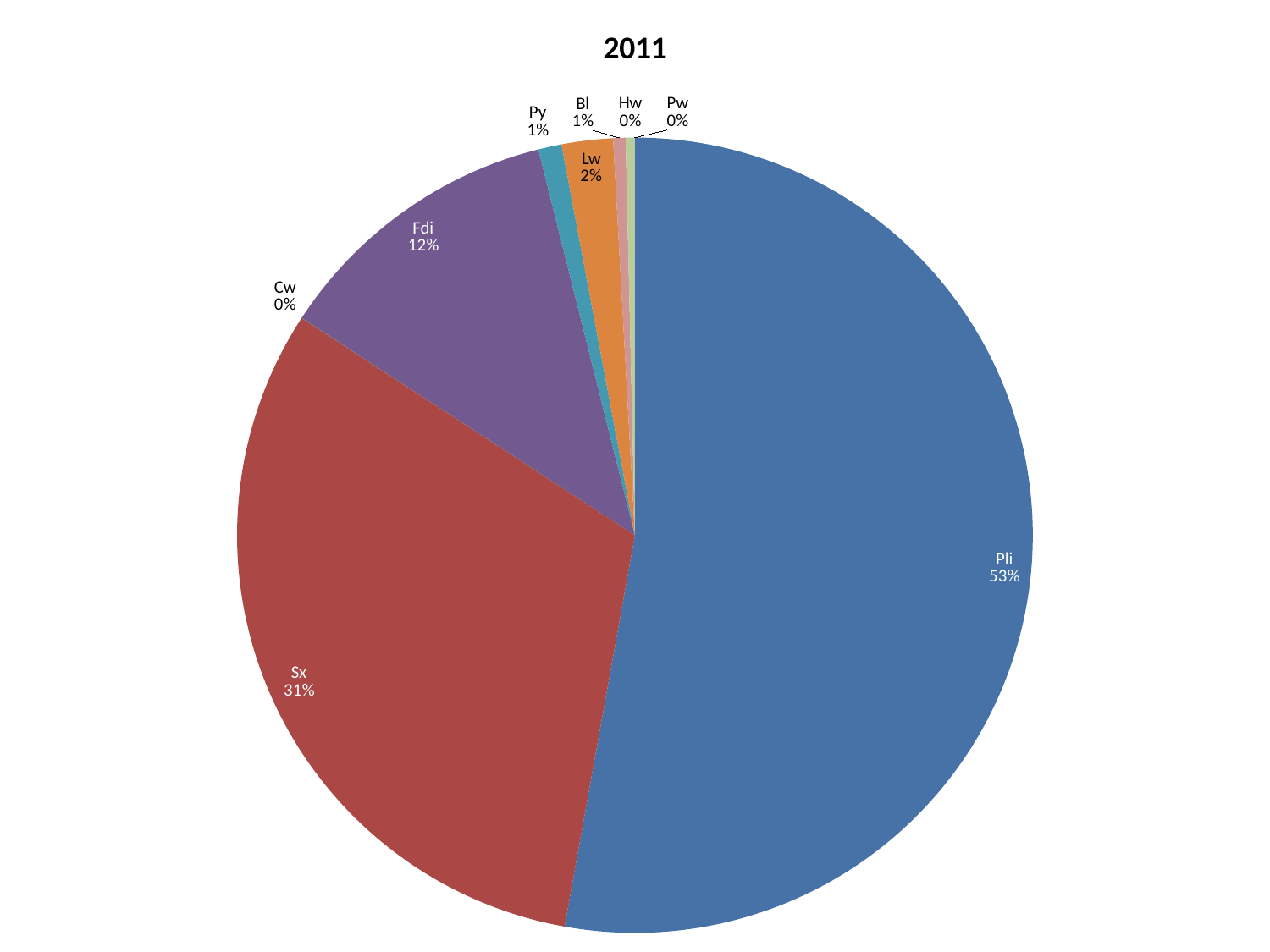
What share of the pie does Lw have? 2% What share of the pie does Pli have? 53% What is the title of the chart? 2011 Which category has the largest slice of the pie? Pli What share of the pie does Fdi have? 12% Which is larger, the slice for Sx or the slice for Fdi? Sx What type of chart is shown on the slide? pie chart How many categories are labelled on the pie chart? 9 What percentage is shown for Py? 1% What is the difference in percentage points between Pli and Sx? 22 What percentage is shown for Cw? 0%